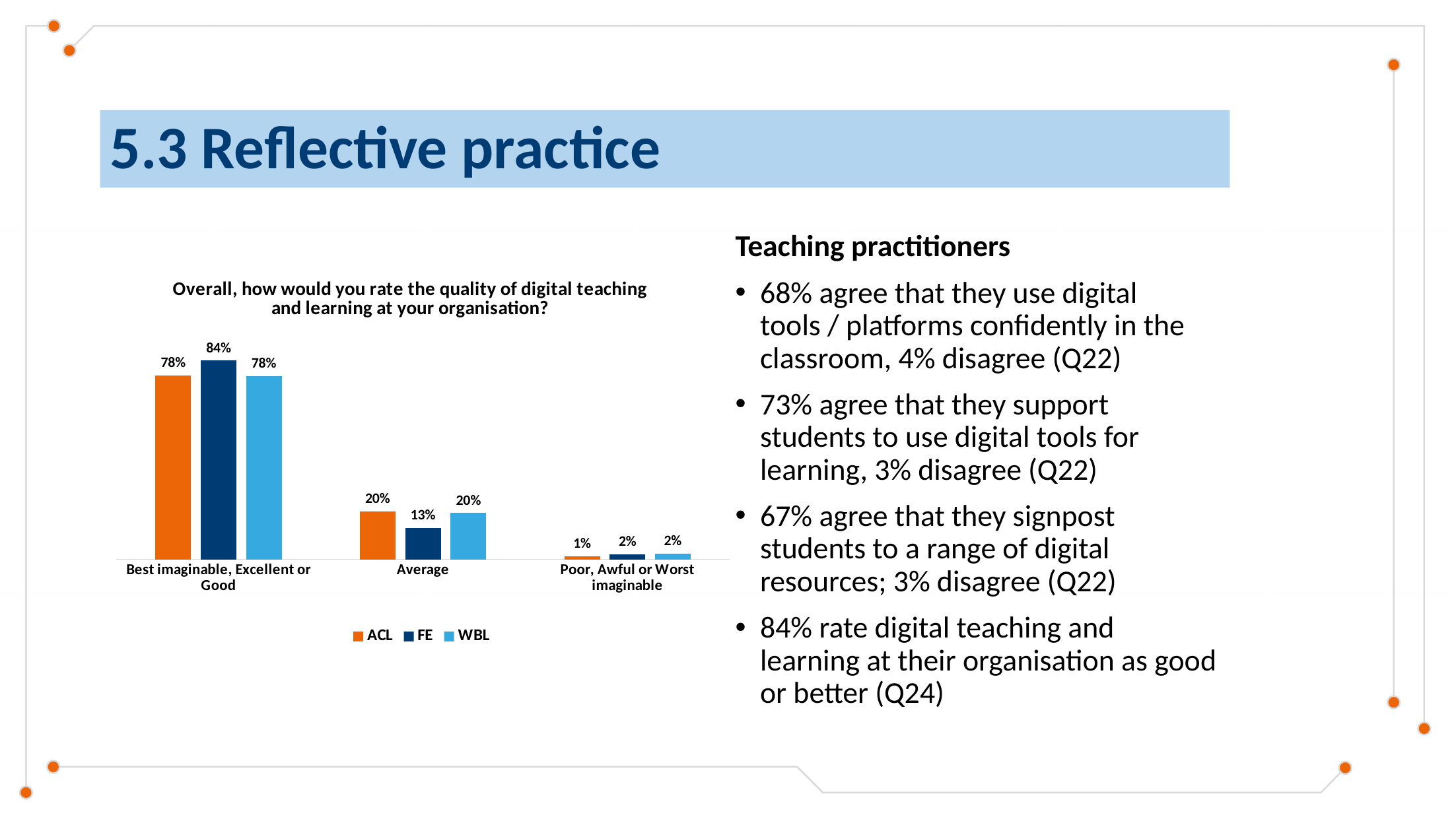
How many categories are shown on the x axis of the chart? 3 What is the title of the chart? Overall, how would you rate the quality of digital teaching and learning at your organisation? What is the difference between the FE and ACL values in the 'Best imaginable, Excellent or Good' category? 6% What is the value for WBL in the 'Poor, Awful or Worst imaginable' category? 2% What is the difference between the WBL and FE values in the 'Average' category? 7% What is the value for FE in the 'Best imaginable, Excellent or Good' category? 84% What is the value for ACL in the 'Average' category? 20% Which series has the lowest value in the 'Average' category? FE Which series has the highest value in the 'Best imaginable, Excellent or Good' category? FE How many series does the chart legend list? 3 What kind of chart is shown on the slide? Bar chart Which is larger: the ACL value for 'Average' or the FE value for 'Average'? ACL